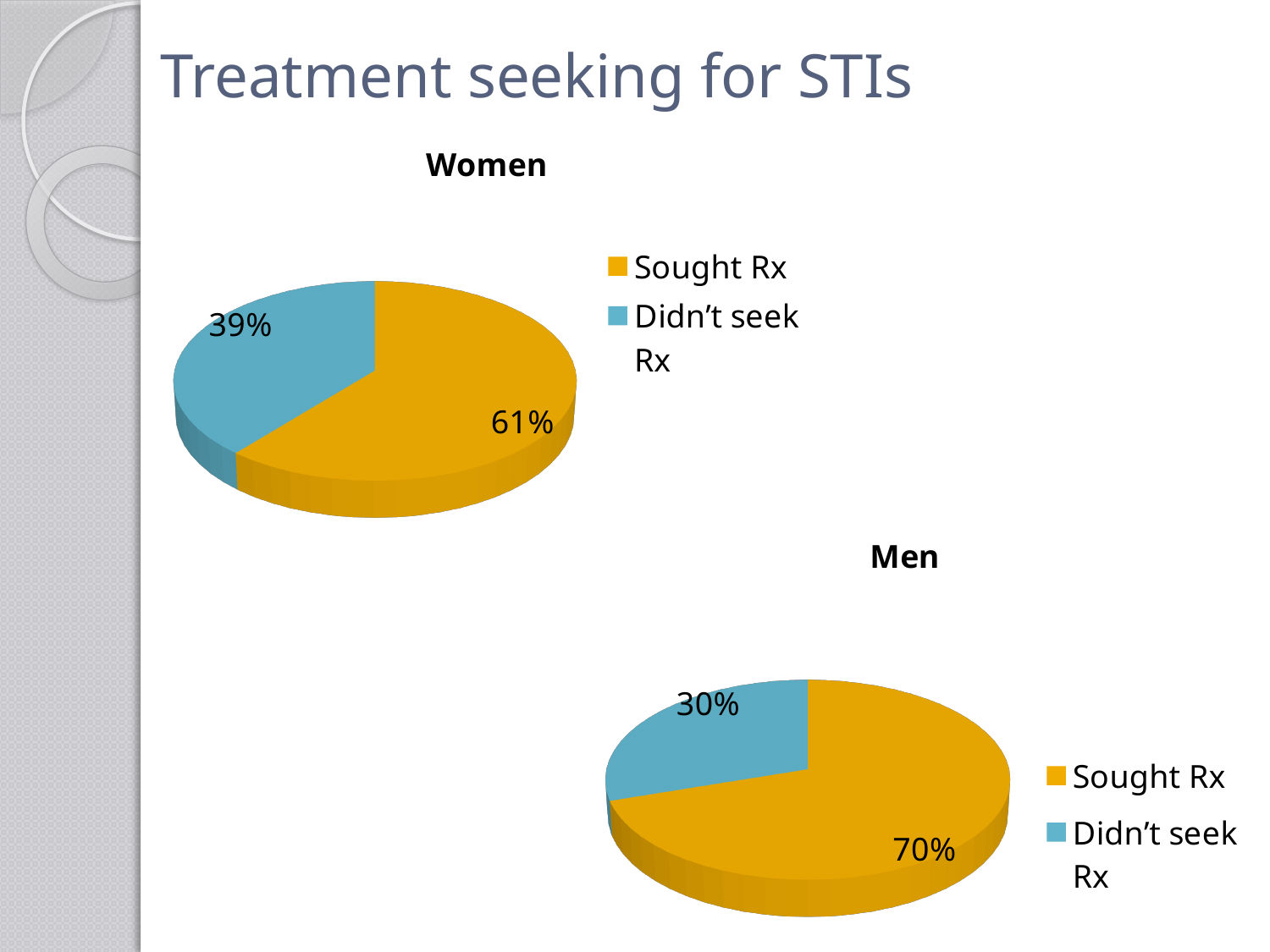
In the Women chart, what percentage didn't seek Rx? 39% In the Men chart, what percentage didn't seek Rx? 30% Which is larger: the Sought Rx share in the Women chart or the Sought Rx share in the Men chart? Men In the Men chart, what is the difference between the Sought Rx and Didn't seek Rx slices? 40% How many categories does the legend of the Men chart list? 2 In the Women chart, which category has the largest slice? Sought Rx In the Men chart, what percentage sought Rx? 70% In the Men chart, what colour is the Sought Rx slice? Orange/gold What kind of chart is the Women chart? Pie chart In the Women chart, what percentage sought Rx? 61% In the Men chart, which category has the smallest slice? Didn't seek Rx In the Women chart, what is the difference between the Sought Rx and Didn't seek Rx slices? 22%